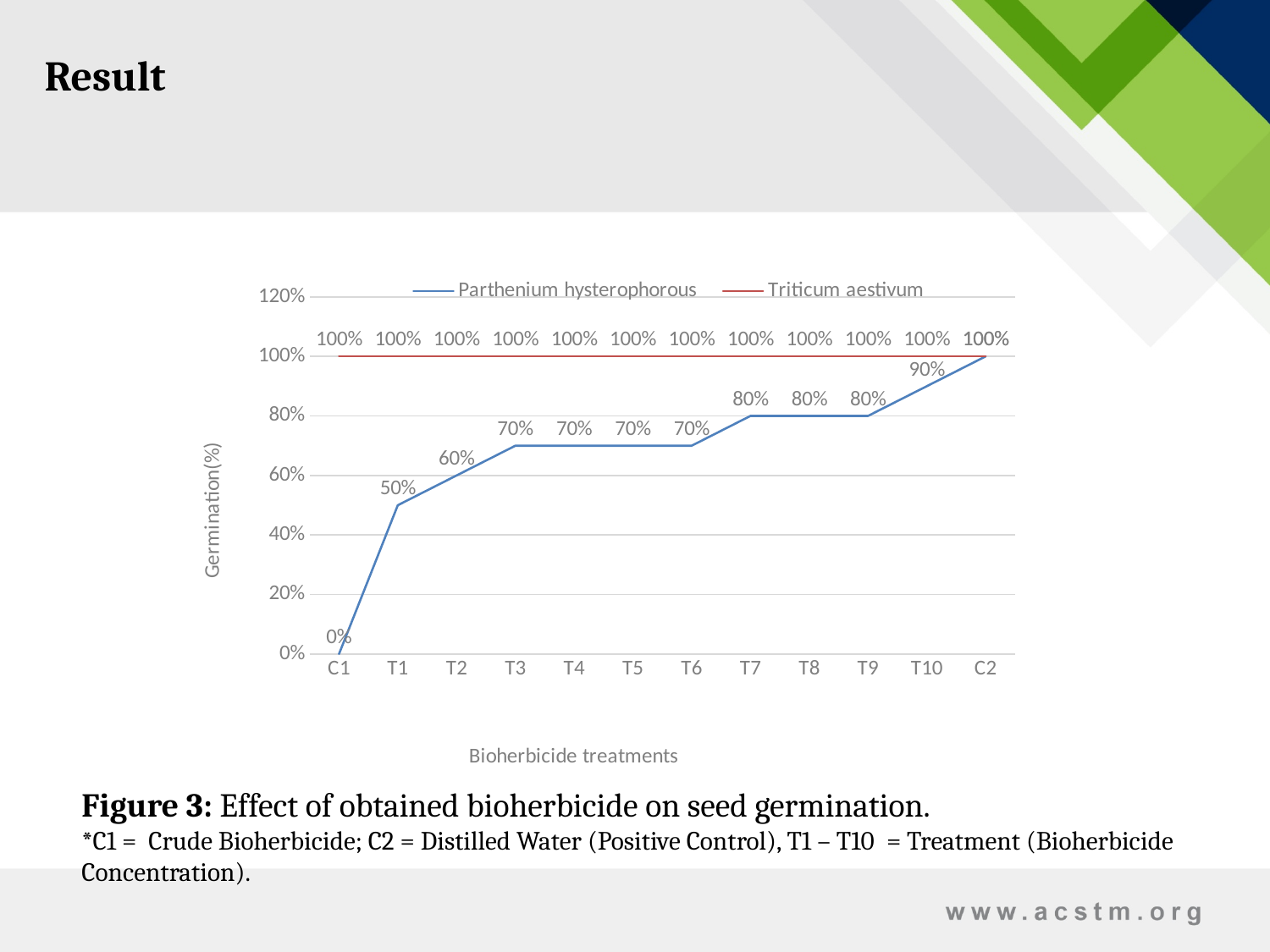
Does the Parthenium hysterophorous line rise or fall from C1 to C2? rise How many treatment categories are shown on the x axis? 12 Which treatment has the lowest germination value for Parthenium hysterophorous? C1 What type of chart is shown on the slide? line chart How many series does the legend list? 2 What is the germination value for Parthenium hysterophorous at C1? 0% What is the germination value for Triticum aestivum at T5? 100% Which is larger at T7: the Parthenium hysterophorous value or the Triticum aestivum value? Triticum aestivum What is the germination value for Parthenium hysterophorous at T1? 50% What is the difference between the Triticum aestivum and Parthenium hysterophorous germination values at T3? 30% What is the label of the y axis? Germination(%) What is the germination value for Parthenium hysterophorous at T10? 90%